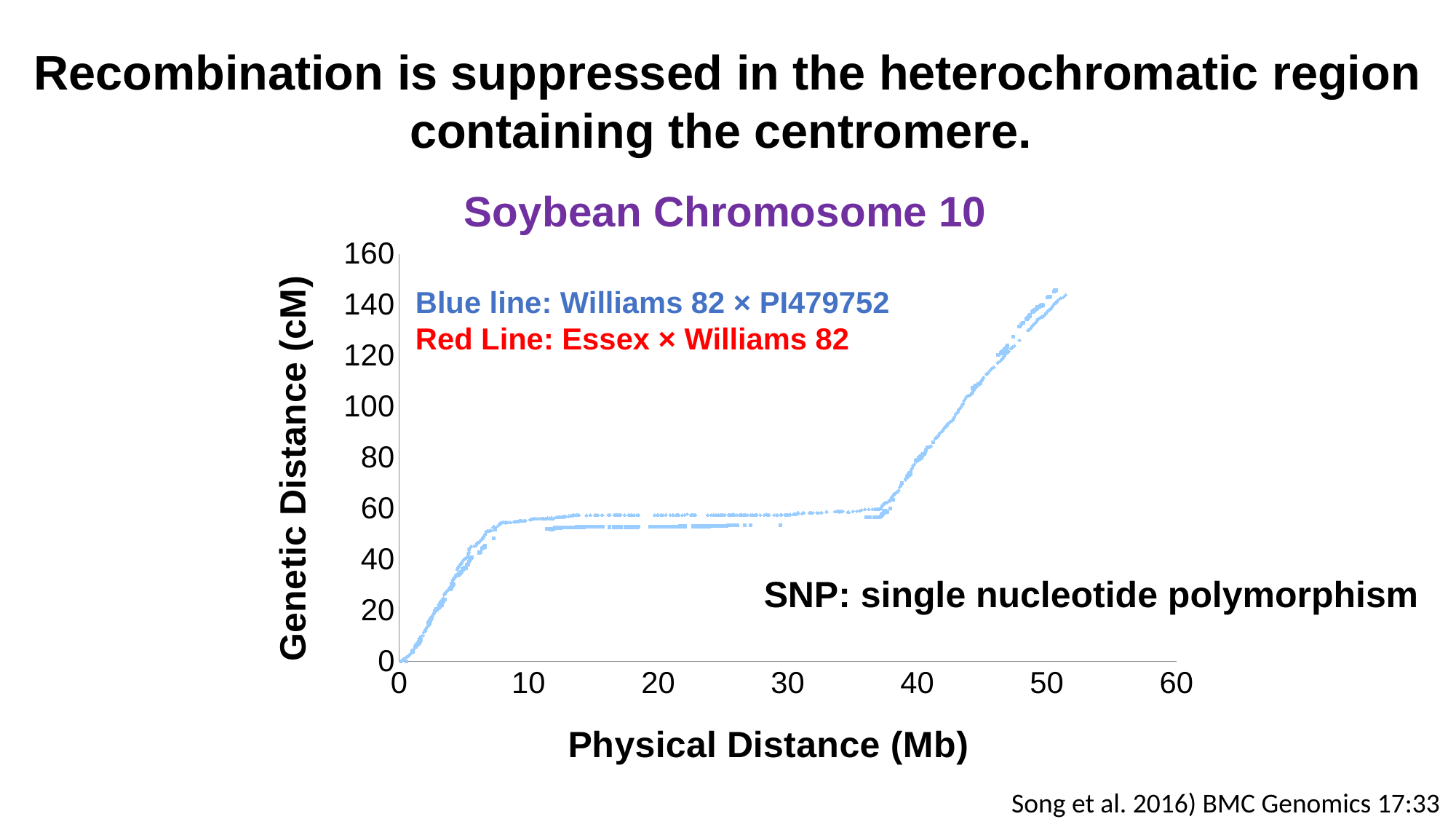
What is the highest tick value shown on the y axis? 160 What is the highest tick value shown on the x axis? 60 What is the title of the chart? Soybean Chromosome 10 Between about 10 Mb and 35 Mb, does the curve rise steeply or stay nearly flat? Nearly flat Is the genetic distance at 45 Mb greater or less than 80 cM? greater Overall, does genetic distance rise or fall as physical distance increases along the x axis? Rises Is the genetic distance at 10 Mb greater or less than 40 cM? greater Is the genetic distance at 20 Mb greater or less than 60 cM? less What kind of chart is shown on the slide? Line chart What is the label of the y axis? Genetic Distance (cM)